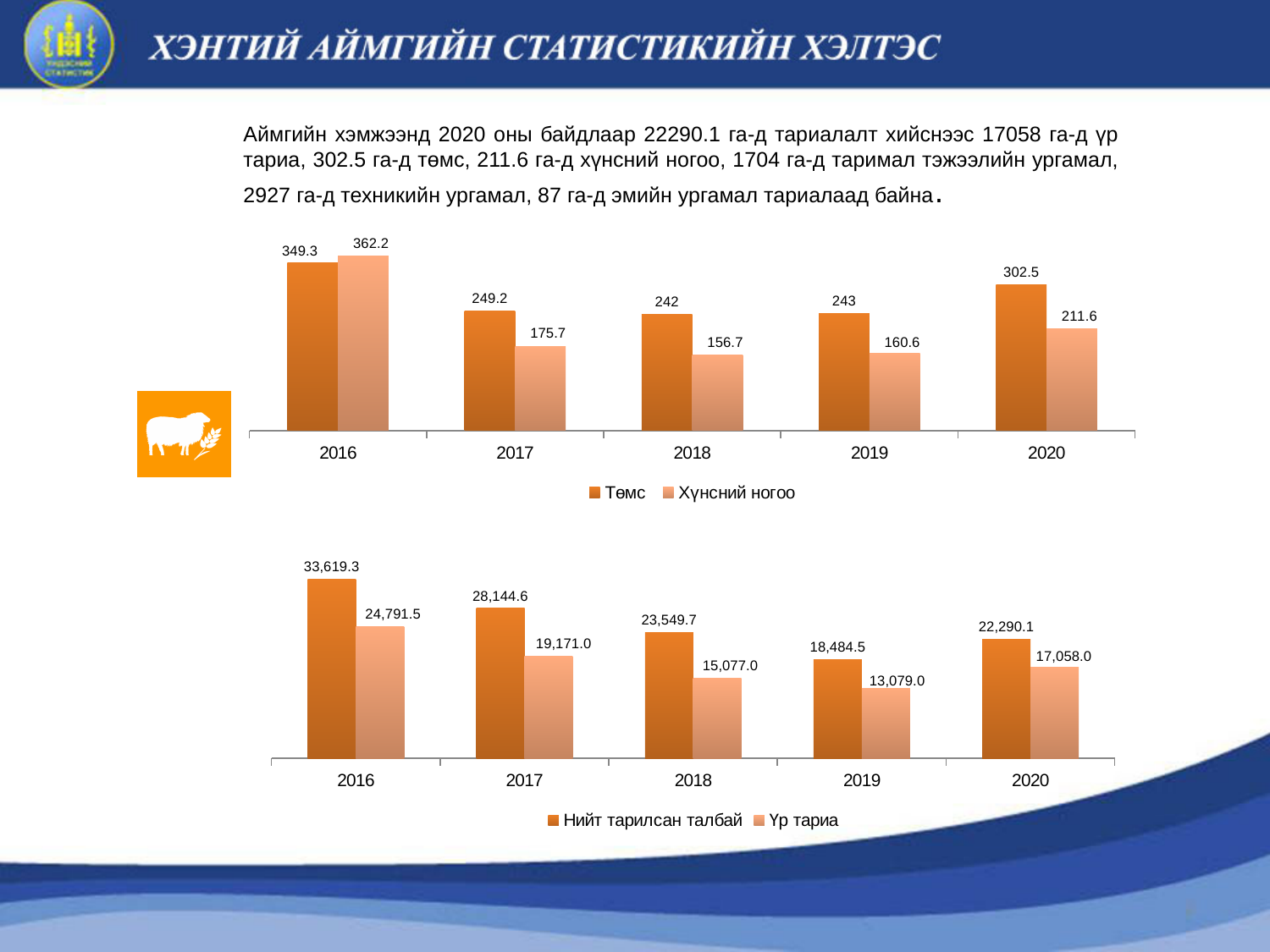
In the top chart, what is the value for Хүнсний ногоо in 2018? 156.7 In the top chart, what is the value for Төмс in 2020? 302.5 In the bottom chart, which year has the lowest value for Үр тариа? 2019 In the top chart, which year has the lowest value for Төмс? 2018 In the top chart, how many series does the legend list? 2 In the bottom chart, what is the difference between Нийт тарилсан талбай and Үр тариа in 2016? 8,827.8 In the bottom chart, what is the value for Үр тариа in 2017? 19,171.0 In the bottom chart, what is the value for Нийт тарилсан талбай in 2019? 18,484.5 In the top chart, which is larger in 2016, Төмс or Хүнсний ногоо? Хүнсний ногоо In the top chart, what is the difference between Төмс and Хүнсний ногоо in 2020? 90.9 In the top chart, which year has the highest value for Хүнсний ногоо? 2016 What kind of chart is the bottom chart? Bar chart